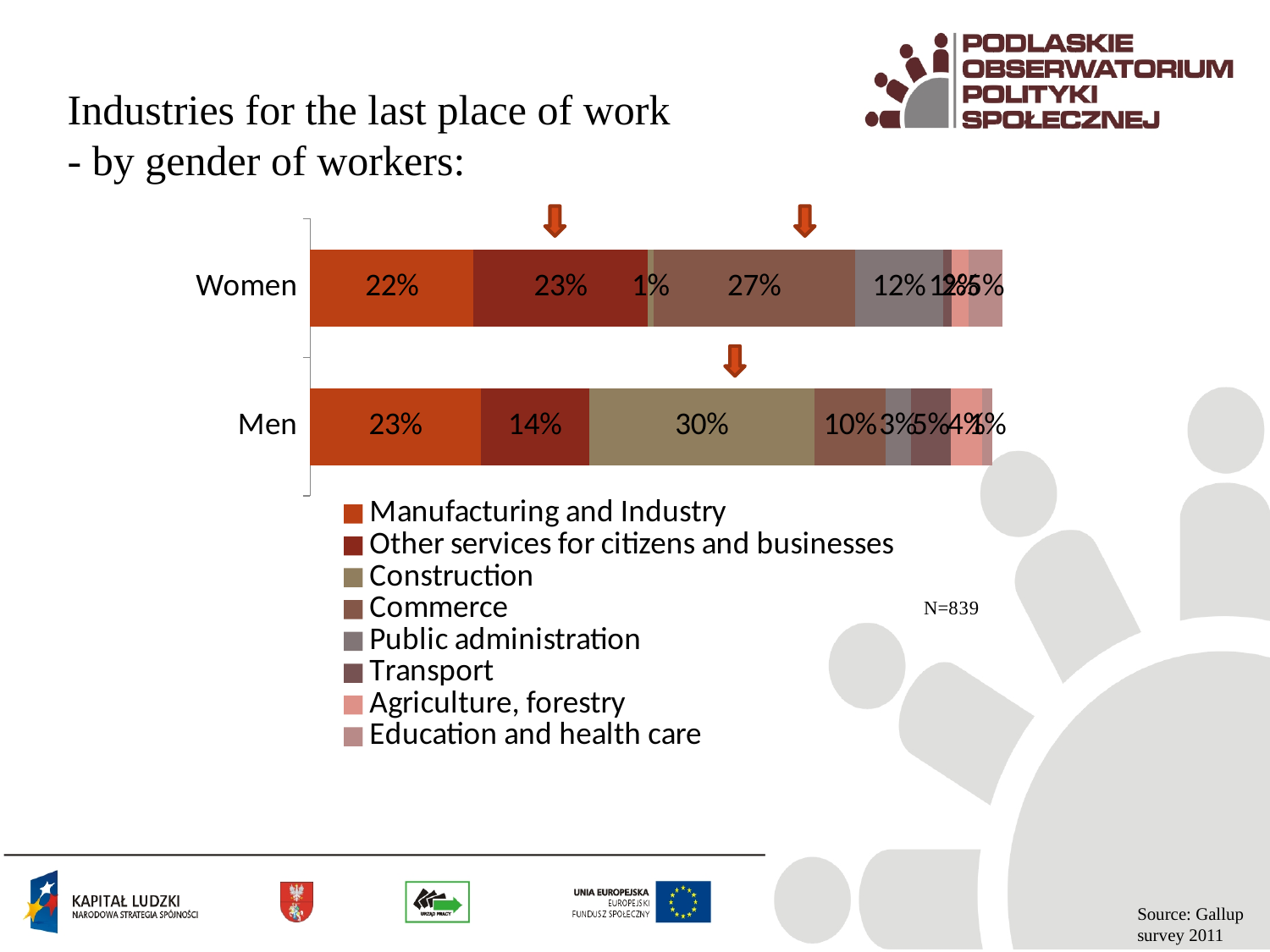
How many categories (bars) does the chart show? 2 Which gender has the larger share in Other services for citizens and businesses? Women Which industry has the largest share for men? Construction How many series does the legend list? 8 What share of women worked in Commerce? 27% What share of men worked in Construction? 30% What share of women worked in Manufacturing and Industry? 22% Which industry has the largest share for women? Commerce What share of women worked in Public administration? 12% What is the difference in percentage points between men and women in Construction? 29 percentage points What kind of chart is shown on the slide? Stacked bar chart What share of men worked in Other services for citizens and businesses? 14%